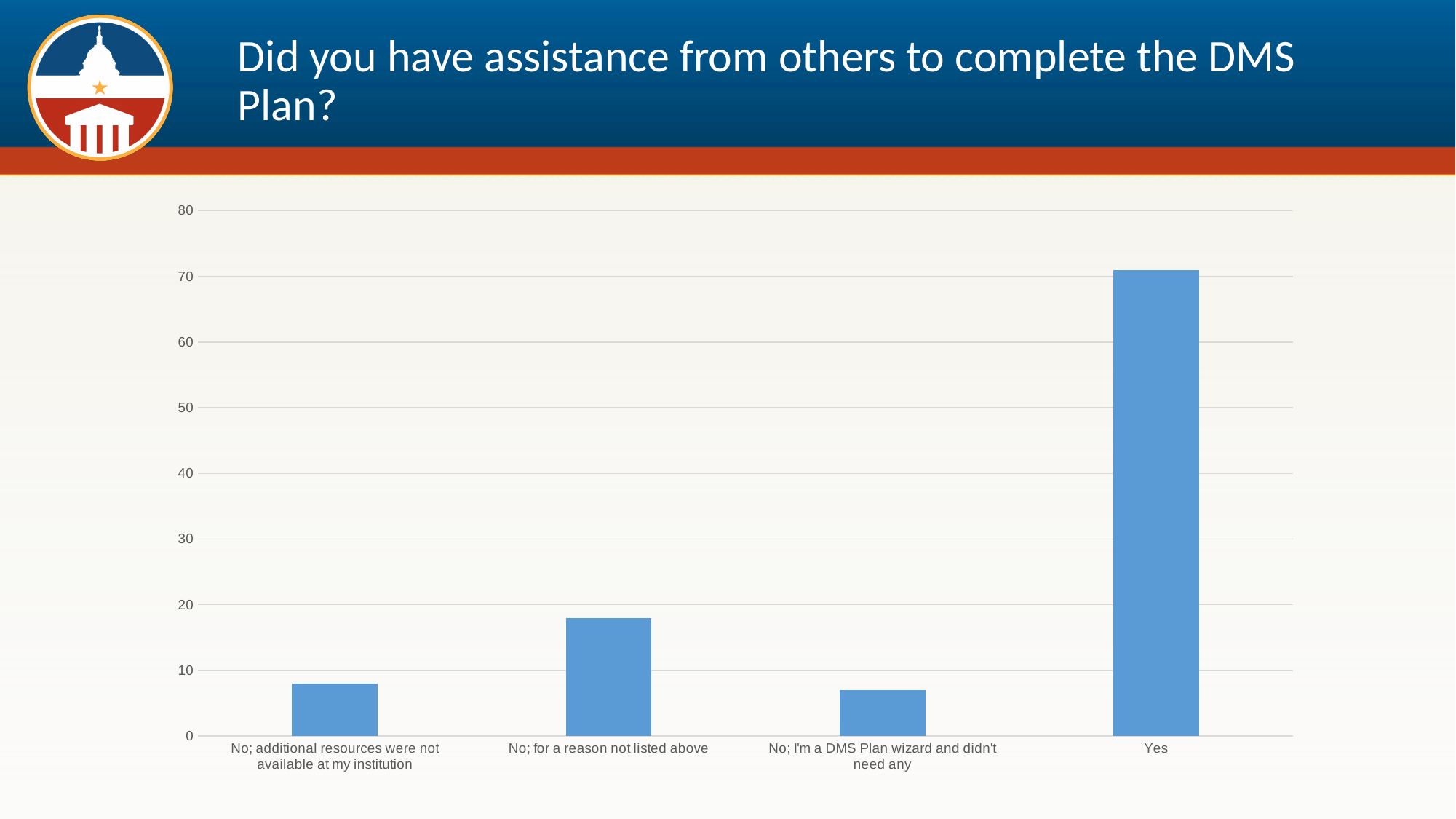
Is the value for "Yes" greater or less than 60? greater Is the value for "No; I'm a DMS Plan wizard and didn't need any" greater or less than 10? less How many categories are shown on the x axis of the chart? 4 Is the value for "No; for a reason not listed above" greater or less than 10? greater What is the highest value shown on the chart's vertical axis? 80 Which is larger: the value for "No; for a reason not listed above" or the value for "No; additional resources were not available at my institution"? No; for a reason not listed above What is the title of the slide containing the chart? Did you have assistance from others to complete the DMS Plan? Which is larger: the value for "Yes" or the value for "No; for a reason not listed above"? Yes What kind of chart is shown on the slide? bar chart Which category has the highest value in the chart? Yes